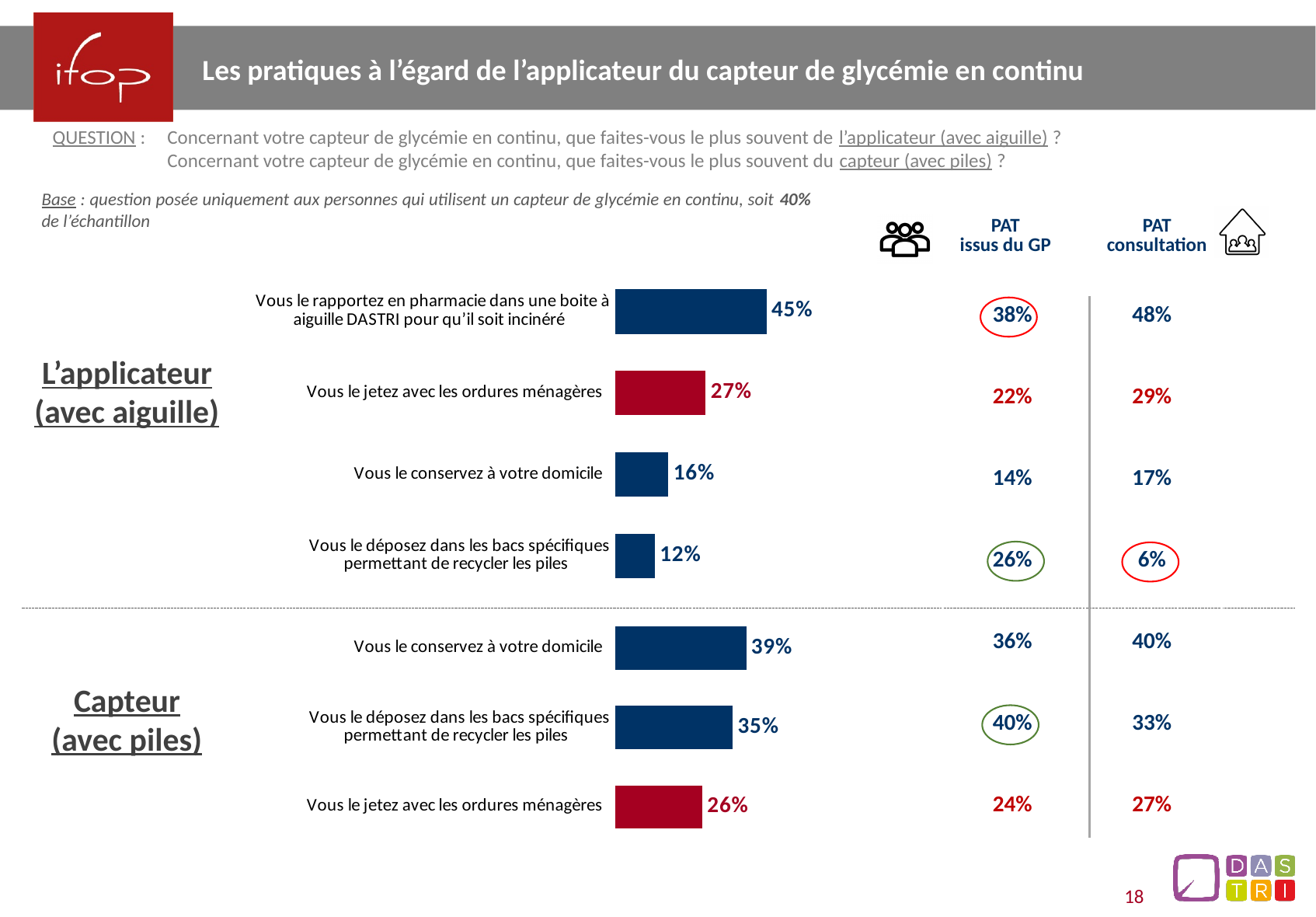
In the "L'applicateur (avec aiguille)" chart, what is the difference between "Vous le rapportez en pharmacie..." (45%) and "Vous le jetez avec les ordures ménagères" (27%)? 18% In the "L'applicateur (avec aiguille)" chart, which category has the lowest value? Vous le déposez dans les bacs spécifiques permettant de recycler les piles In the "L'applicateur (avec aiguille)" chart, what is the value for "Vous le jetez avec les ordures ménagères"? 27% What type of chart is used for the "Capteur (avec piles)" section? Bar chart In the "L'applicateur (avec aiguille)" section, what is the "PAT consultation" value for "Vous le déposez dans les bacs spécifiques permettant de recycler les piles"? 6% How many categories are shown in the "L'applicateur (avec aiguille)" chart? 4 In the "Capteur (avec piles)" chart, what is the value for "Vous le conservez à votre domicile"? 39% In the "Capteur (avec piles)" chart, which category has the highest value? Vous le conservez à votre domicile How many categories are shown in the "Capteur (avec piles)" chart? 3 In the "L'applicateur (avec aiguille)" chart, what is the value for "Vous le rapportez en pharmacie dans une boite à aiguille DASTRI pour qu'il soit incinéré"? 45% In the "Capteur (avec piles)" chart, which is larger: "Vous le conservez à votre domicile" or "Vous le jetez avec les ordures ménagères"? Vous le conservez à votre domicile In the "Capteur (avec piles)" chart, what is the value for "Vous le déposez dans les bacs spécifiques permettant de recycler les piles"? 35%